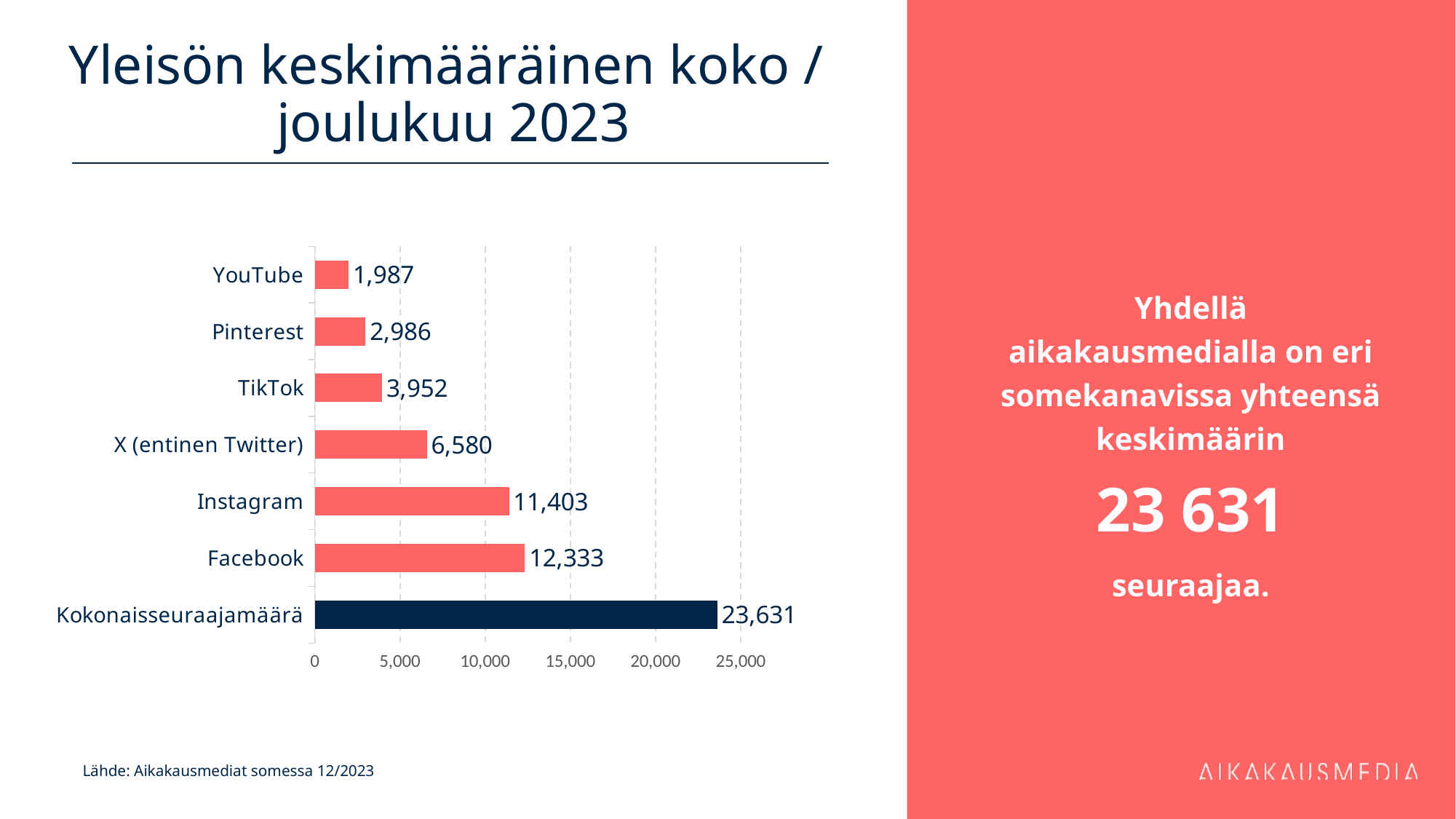
What is the value for Instagram? 11,403 What is the value for YouTube? 1,987 Which is larger, the value for X (entinen Twitter) or the value for TikTok? X (entinen Twitter) What is the value for Facebook? 12,333 Which category has the lowest value? YouTube What kind of chart is shown on the slide? Bar chart Which category has the highest value? Kokonaisseuraajamäärä What is the value for X (entinen Twitter)? 6,580 How many categories are shown in the chart? 7 What is the difference between the values for Facebook and Instagram? 930 What is the title of the slide containing the chart? Yleisön keskimääräinen koko / joulukuu 2023 What is the difference between the values for TikTok and Pinterest? 966